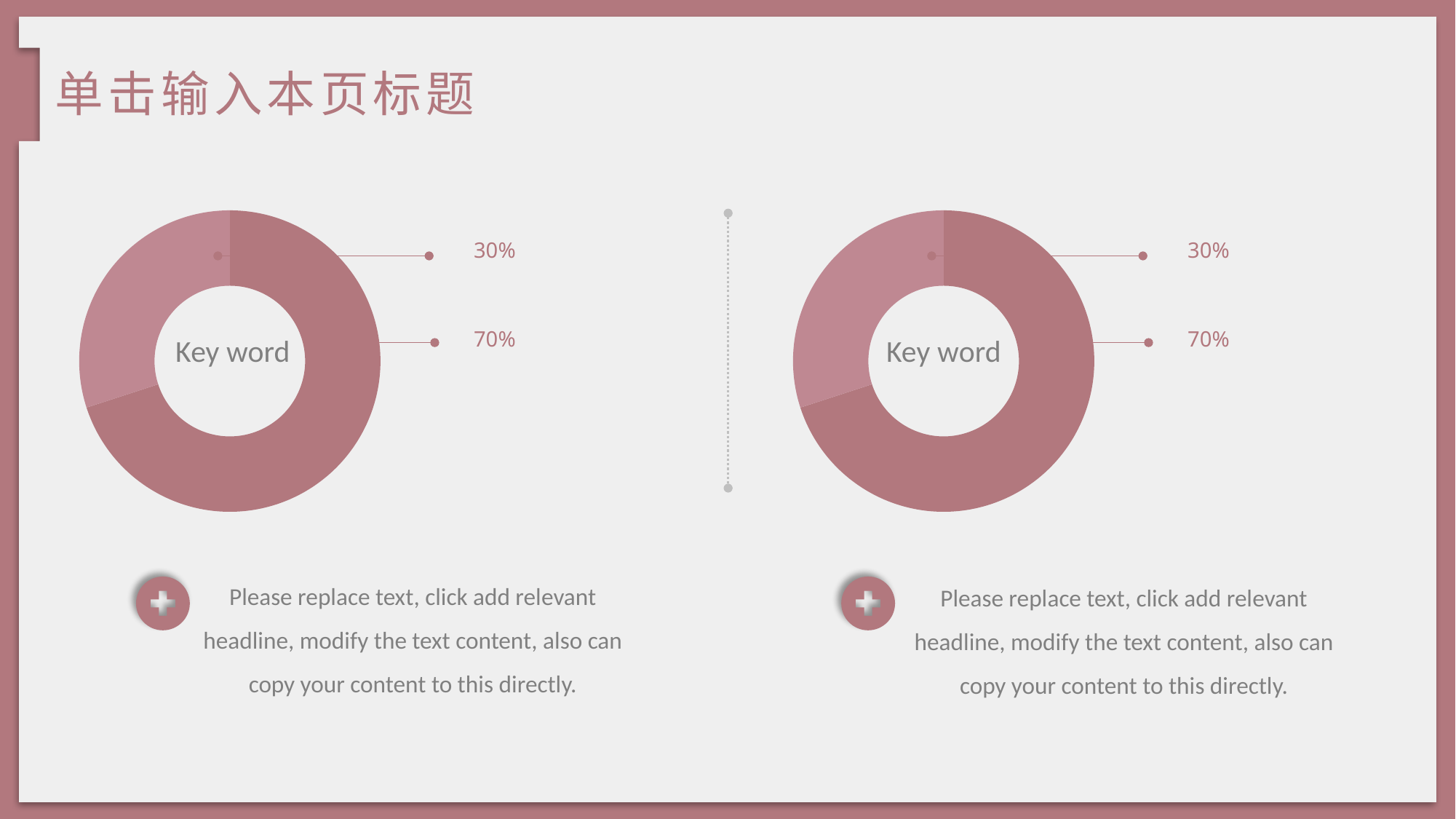
How many donut charts are on the slide? 2 What kind of chart is shown on the right side of the slide? Donut chart What kind of chart is shown on the left side of the slide? Donut chart In the left donut chart, what is the difference between the two labelled percentages? 40% How many slices does the left donut chart have? 2 In the left donut chart, what percentage is shown for the larger, darker slice? 70% How many slices does the right donut chart have? 2 In the right donut chart, which slice is larger, the one labelled 30% or the one labelled 70%? 70% In the right donut chart, what percentage is shown for the smaller, lighter slice? 30% In the right donut chart, what percentage is shown for the larger, darker slice? 70% What text appears in the centre of the left donut chart? Key word In the left donut chart, what percentage is shown for the smaller, lighter slice? 30%